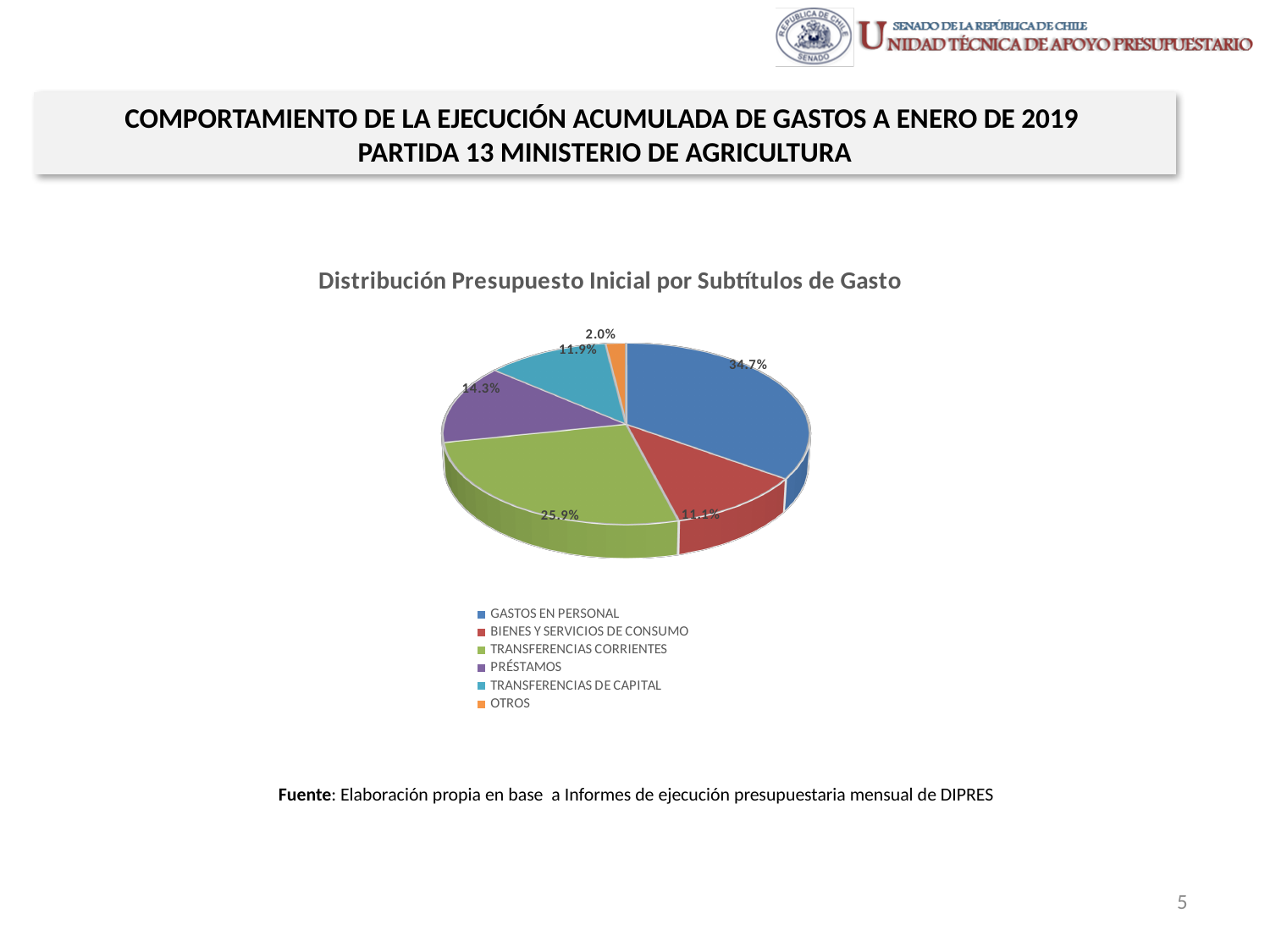
What share of the pie does OTROS represent? 2.0% Which category has the smallest slice of the pie? OTROS What share of the pie does GASTOS EN PERSONAL represent? 34.7% How many categories does the legend list? 6 What is the title of the chart? Distribución Presupuesto Inicial por Subtítulos de Gasto Which is larger, the share for PRÉSTAMOS or the share for TRANSFERENCIAS DE CAPITAL? PRÉSTAMOS What kind of chart is shown on the slide? Pie chart Which category has the largest slice of the pie? GASTOS EN PERSONAL What share of the pie does TRANSFERENCIAS CORRIENTES represent? 25.9% What colour is the slice for TRANSFERENCIAS CORRIENTES? Green What is the difference in percentage points between GASTOS EN PERSONAL and TRANSFERENCIAS CORRIENTES? 8.8